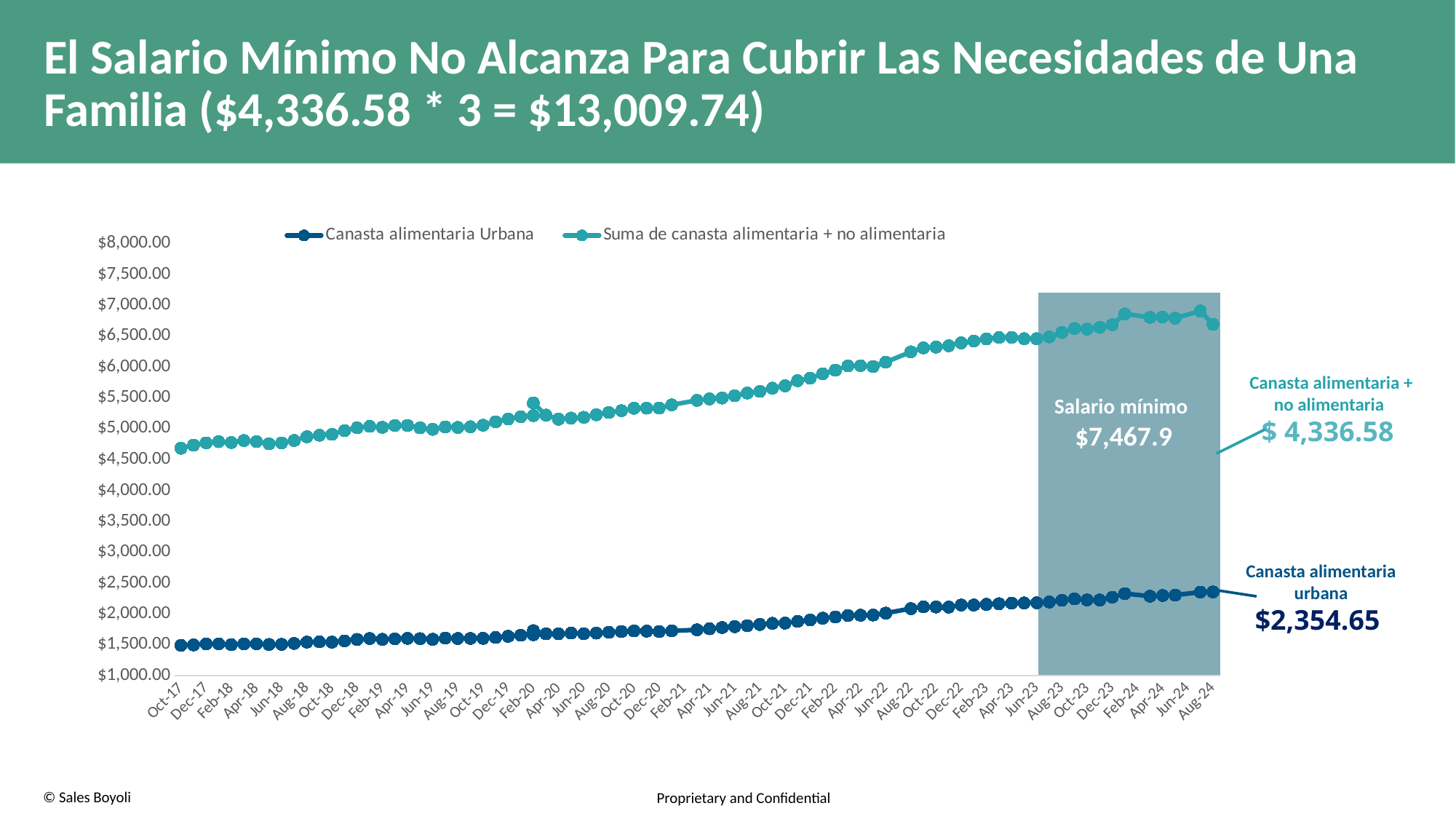
What is the difference between the annotated values $4,336.58 (Canasta alimentaria + no alimentaria) and $2,354.65 (Canasta alimentaria urbana)? $1,981.93 Does the Canasta alimentaria Urbana series rise or fall from Oct-17 to Aug-24? rises What value is annotated for Canasta alimentaria urbana at the right of the chart? $2,354.65 Is the value of Suma de canasta alimentaria + no alimentaria at Aug-24 greater or less than $6,500.00? greater How many series does the chart legend list? 2 What type of chart is shown on the slide? line chart Is the value of Canasta alimentaria Urbana at Oct-17 greater or less than $2,000.00? less Which series has the higher values across the chart, Canasta alimentaria Urbana or Suma de canasta alimentaria + no alimentaria? Suma de canasta alimentaria + no alimentaria What value is annotated for Canasta alimentaria + no alimentaria at the right of the chart? $ 4,336.58 What Salario mínimo value is printed in the shaded region of the chart? $7,467.9 Is the value of Suma de canasta alimentaria + no alimentaria at Oct-17 greater or less than $5,000.00? less Which series is drawn in dark blue according to the legend? Canasta alimentaria Urbana